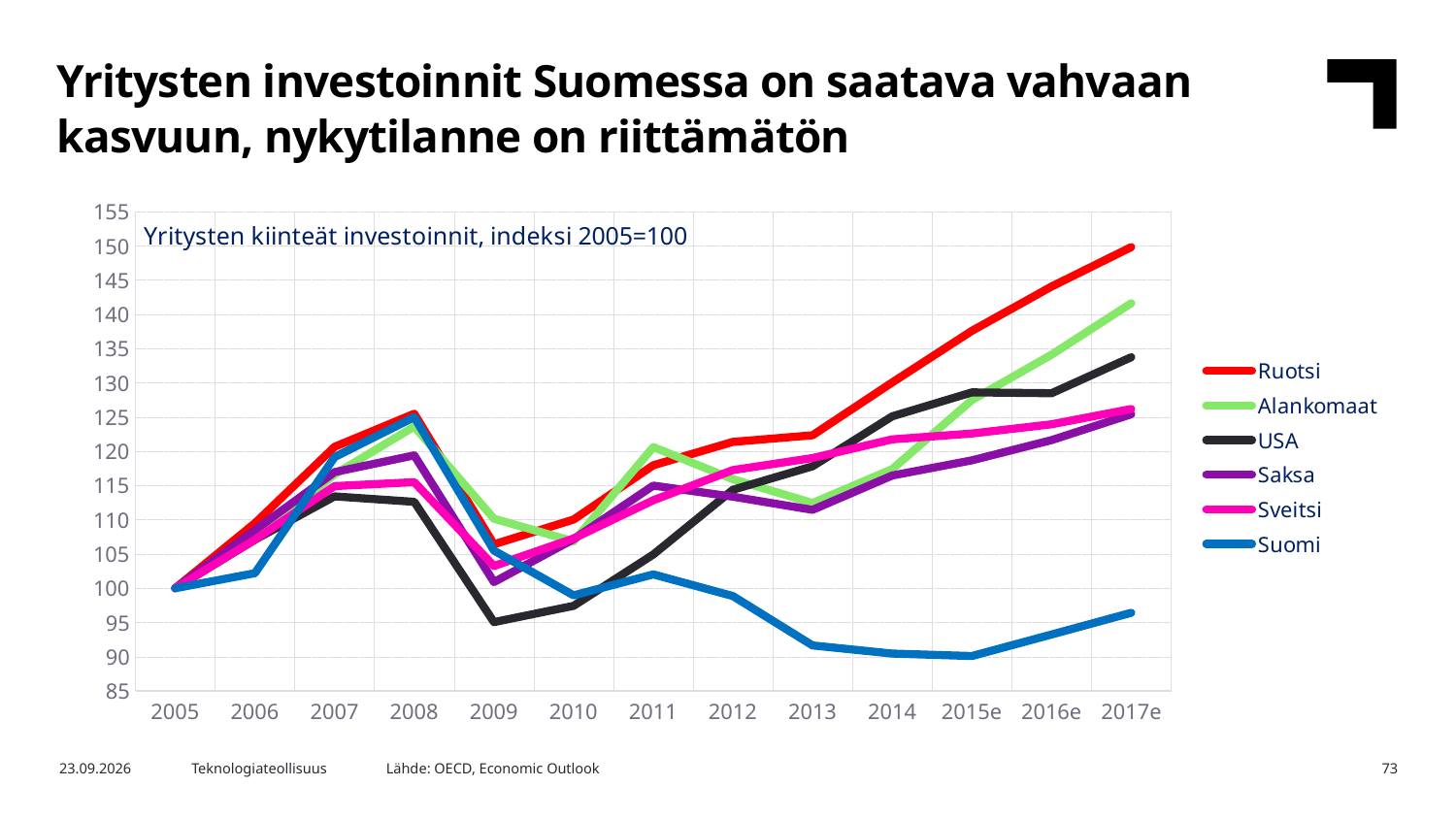
How many series does the legend list? 6 In 2017e, which is higher: Alankomaat or USA? Alankomaat What type of chart is shown on the slide? line chart Which country has the highest index value in 2017e? Ruotsi Is the value for Suomi in 2015e greater or less than 95? less How many years are shown along the x axis? 13 Does the Suomi line rise or fall from 2012 to 2015e? fall What is the subtitle printed inside the chart area? Yritysten kiinteät investoinnit, indeksi 2005=100 Which country has the lowest index value in 2017e? Suomi Is the value for Ruotsi in 2017e greater or less than 140? greater Which country has the lowest index value in 2009? USA What is the index value for Suomi in 2005? 100